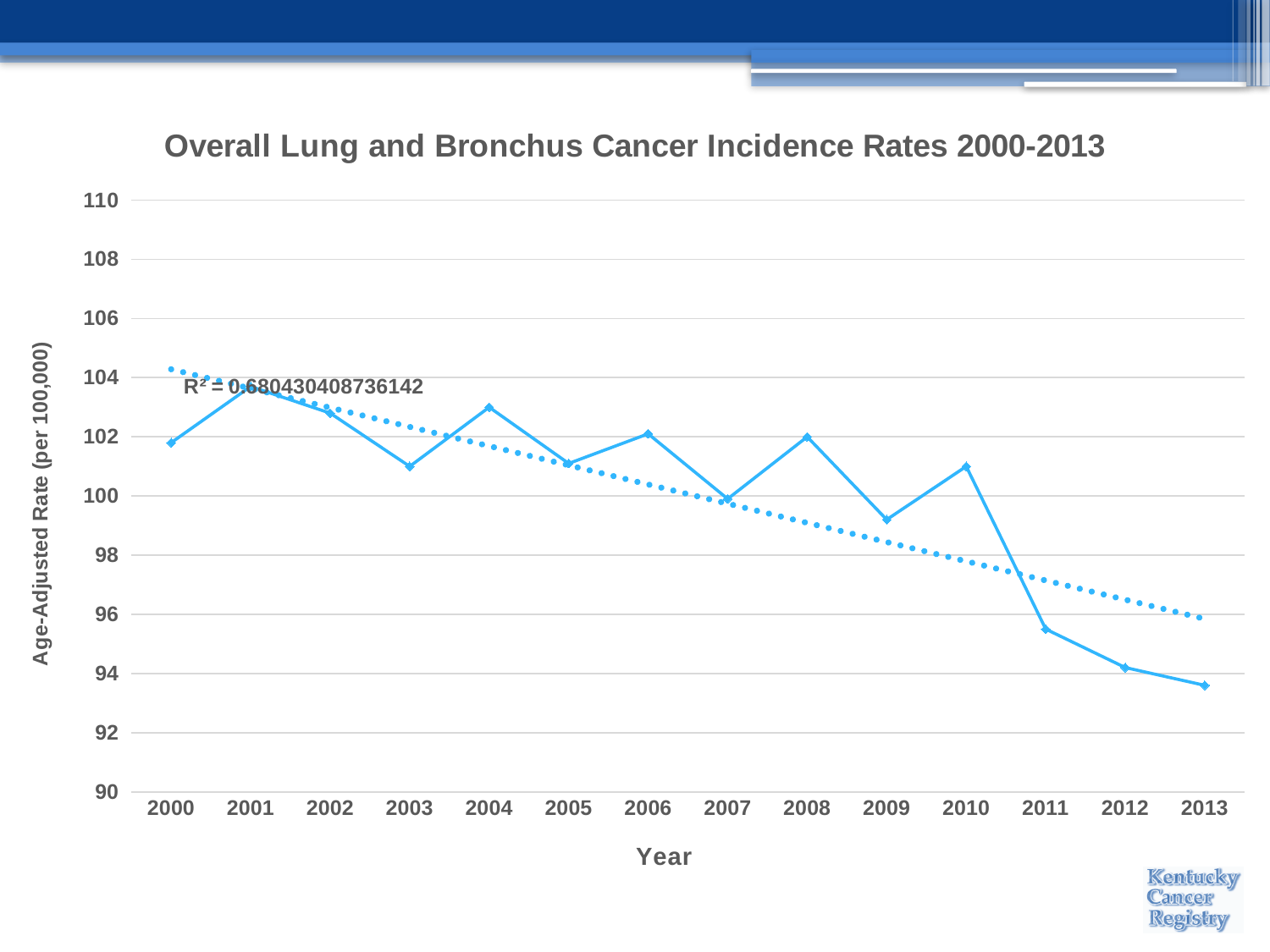
What kind of chart is shown on the slide? line chart Is the value for 2009 greater or less than 100? less Which year has the higher incidence rate, 2006 or 2009? 2006 How many years are plotted along the x axis? 14 Is the value for 2001 greater or less than 102? greater What R² value is printed on the chart for the trendline? R² = 0.680430408736142 Is the value for 2003 greater or less than 100? greater Overall, do the incidence rates rise or fall from 2000 to 2013? fall Which year has the lowest age-adjusted incidence rate? 2013 Which year has the higher incidence rate, 2000 or 2013? 2000